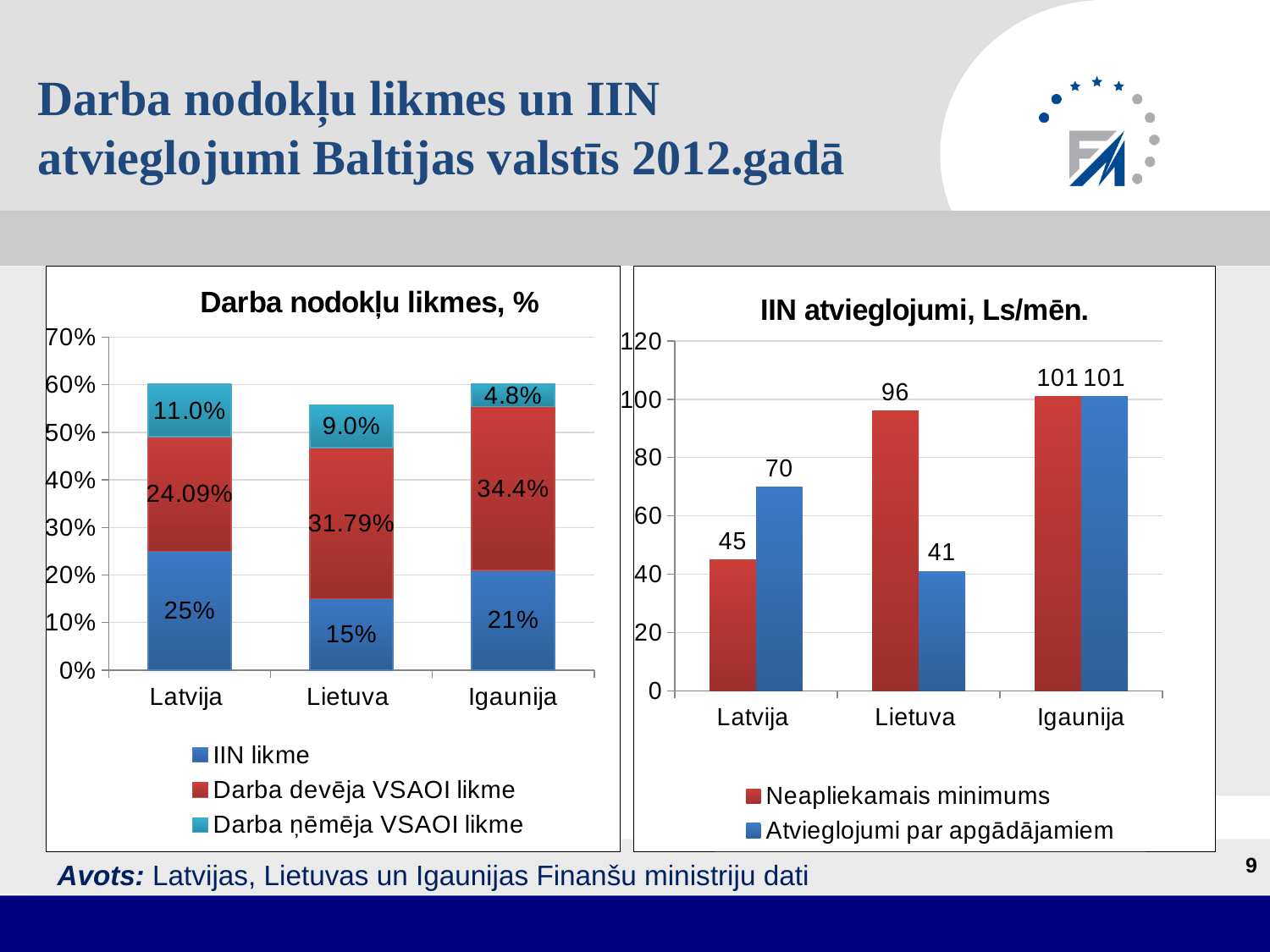
In the 'IIN atvieglojumi, Ls/mēn.' chart, what is the Atvieglojumi par apgādājamiem value for Latvija? 70 In the 'IIN atvieglojumi, Ls/mēn.' chart, which is larger for Lietuva: Neapliekamais minimums or Atvieglojumi par apgādājamiem? Neapliekamais minimums In the 'Darba nodokļu likmes, %' chart, what is the total of the stacked bar for Lietuva? 55.79% In the 'Darba nodokļu likmes, %' chart, how many series does the legend list? 3 What kind of chart is the 'IIN atvieglojumi, Ls/mēn.' chart? Bar chart In the 'IIN atvieglojumi, Ls/mēn.' chart, what is the Neapliekamais minimums value for Lietuva? 96 In the 'IIN atvieglojumi, Ls/mēn.' chart, what is the difference between the Neapliekamais minimums values for Lietuva and Latvija? 51 In the 'Darba nodokļu likmes, %' chart, what is the Darba devēja VSAOI likme value for Igaunija? 34.4% In the 'Darba nodokļu likmes, %' chart, what is the IIN likme value for Lietuva? 15% In the 'Darba nodokļu likmes, %' chart, which country has the lowest Darba ņēmēja VSAOI likme? Igaunija In the 'Darba nodokļu likmes, %' chart, what is the Darba ņēmēja VSAOI likme value for Latvija? 11.0% In the 'Darba nodokļu likmes, %' chart, which country has the highest IIN likme? Latvija